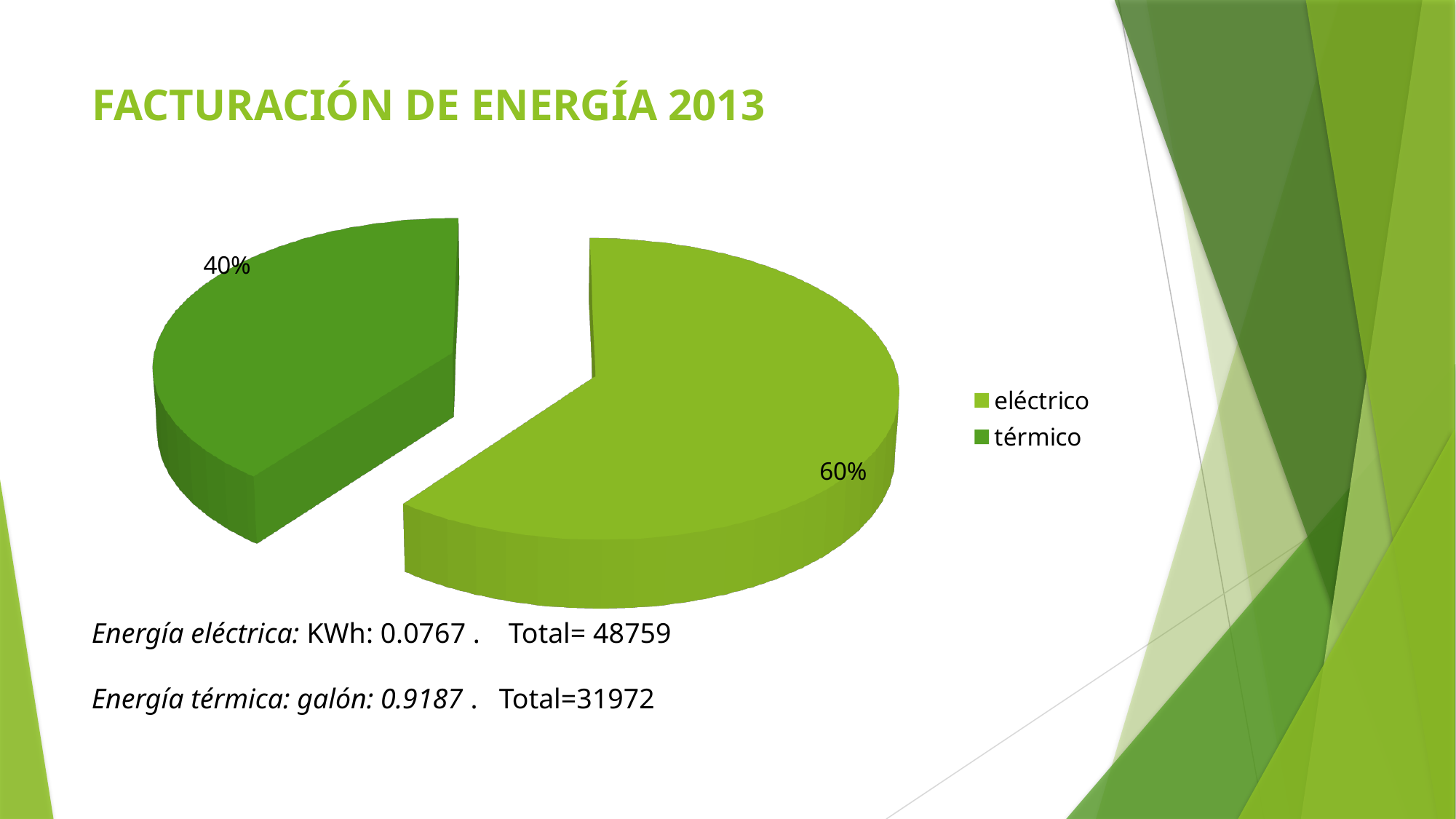
Which category has the largest slice of the pie? eléctrico Which legend entry is shown in the darker green colour? térmico What share of the pie does the eléctrico slice represent? 60% How many slices does the pie chart have? 2 Which category has the smallest slice of the pie? térmico What kind of chart is shown on the slide? Pie chart What is the title of the slide containing the pie chart? FACTURACIÓN DE ENERGÍA 2013 What share of the pie does the térmico slice represent? 40% What is the difference in percentage points between the eléctrico and térmico slices? 20% Which slice is larger, eléctrico or térmico? eléctrico How many entries does the legend list? 2